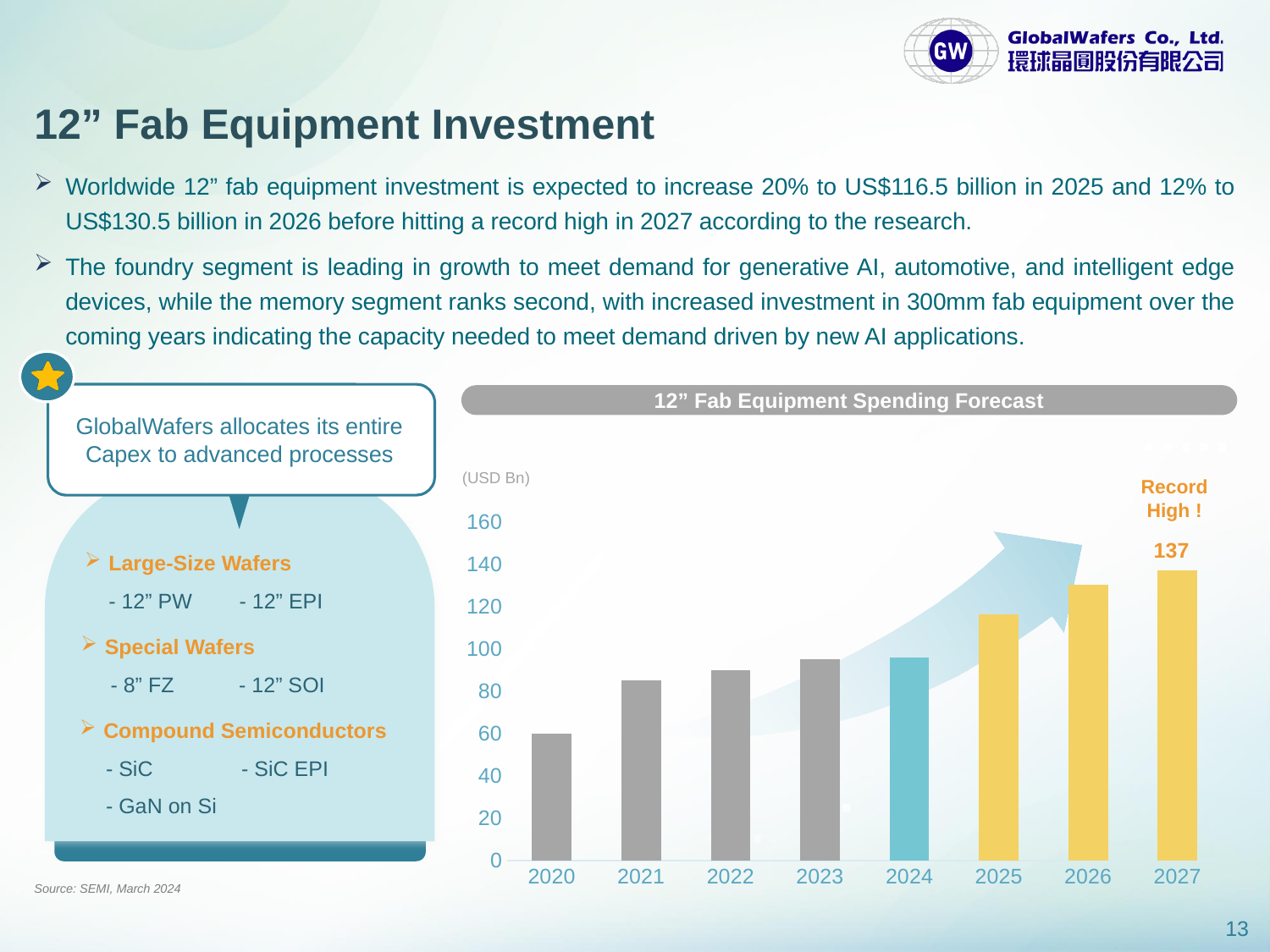
In the 12" Fab Equipment Spending Forecast chart, is the value for 2026 greater or less than 120? greater Do the values in the 12" Fab Equipment Spending Forecast chart generally rise or fall from 2020 to 2027? Rise In the 12" Fab Equipment Spending Forecast chart, is the value for 2025 greater or less than 100? greater What unit is shown for the values in the 12" Fab Equipment Spending Forecast chart? USD Bn What kind of chart is the 12" Fab Equipment Spending Forecast? Bar chart In the 12" Fab Equipment Spending Forecast chart, which is larger, the value for 2021 or the value for 2026? 2026 How many years are shown on the x axis of the 12" Fab Equipment Spending Forecast chart? 8 What is the value for 2027 in the 12" Fab Equipment Spending Forecast chart? 137 Which year has the highest value in the 12" Fab Equipment Spending Forecast chart? 2027 In the 12" Fab Equipment Spending Forecast chart, is the value for 2024 greater or less than 120? less Which year has the lowest value in the 12" Fab Equipment Spending Forecast chart? 2020